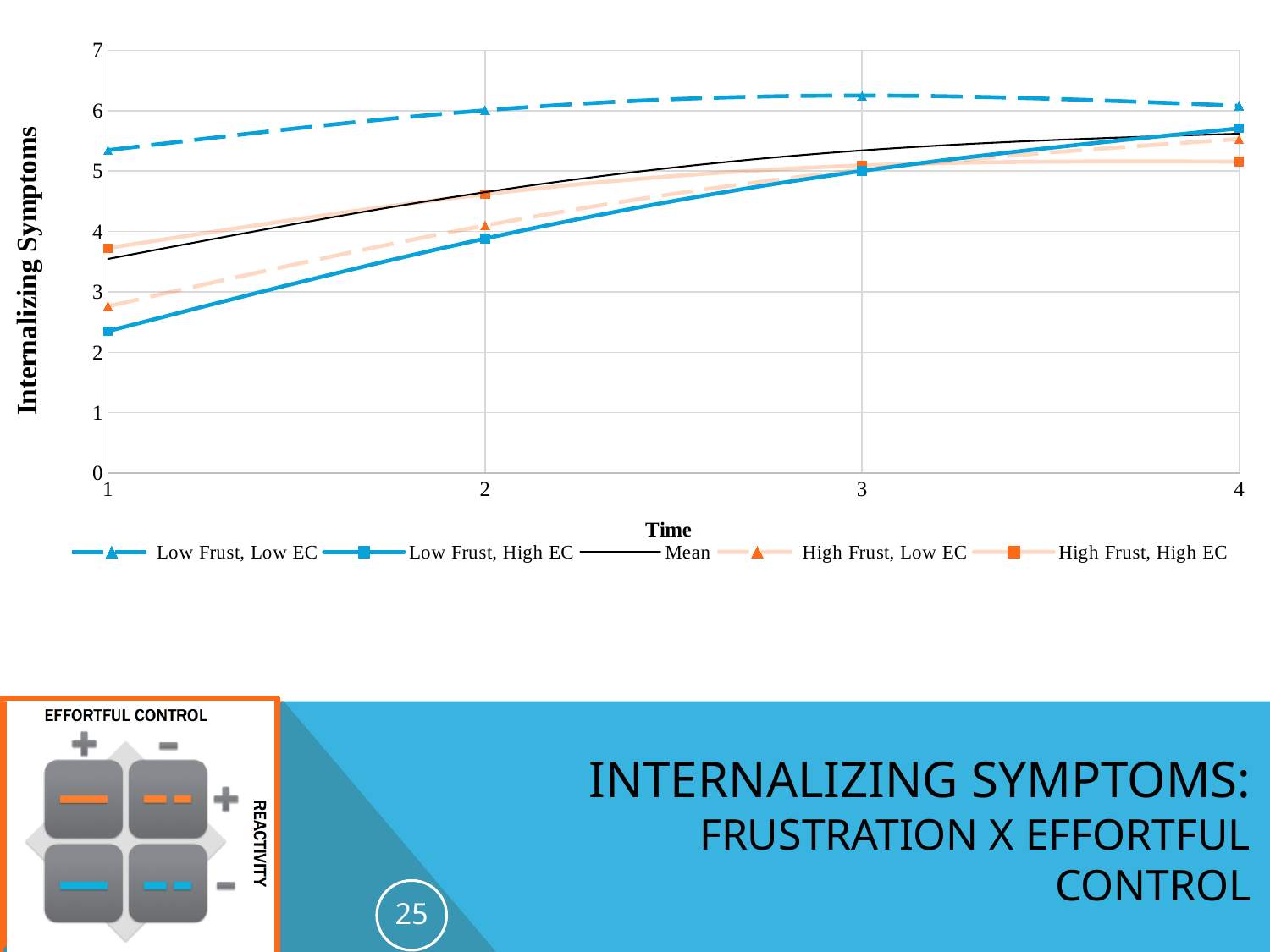
Is the value for Low Frust, Low EC at time 1 greater or less than 5? greater Is the value for Low Frust, Low EC at time 3 greater or less than 6? greater Which series has the highest value at time 4? Low Frust, Low EC How many time points are plotted along the x axis? 4 Do the values for Low Frust, High EC rise or fall from time 1 to time 4? rise Which series has the lowest value at time 1? Low Frust, High EC Is the value for Low Frust, High EC at time 1 greater or less than 3? less Which series has the highest value at time 1? Low Frust, Low EC How many series does the legend list? 5 What is the title of the y axis? Internalizing Symptoms At time 2, which is larger: Low Frust, Low EC or Low Frust, High EC? Low Frust, Low EC What kind of chart is shown on the slide? line chart